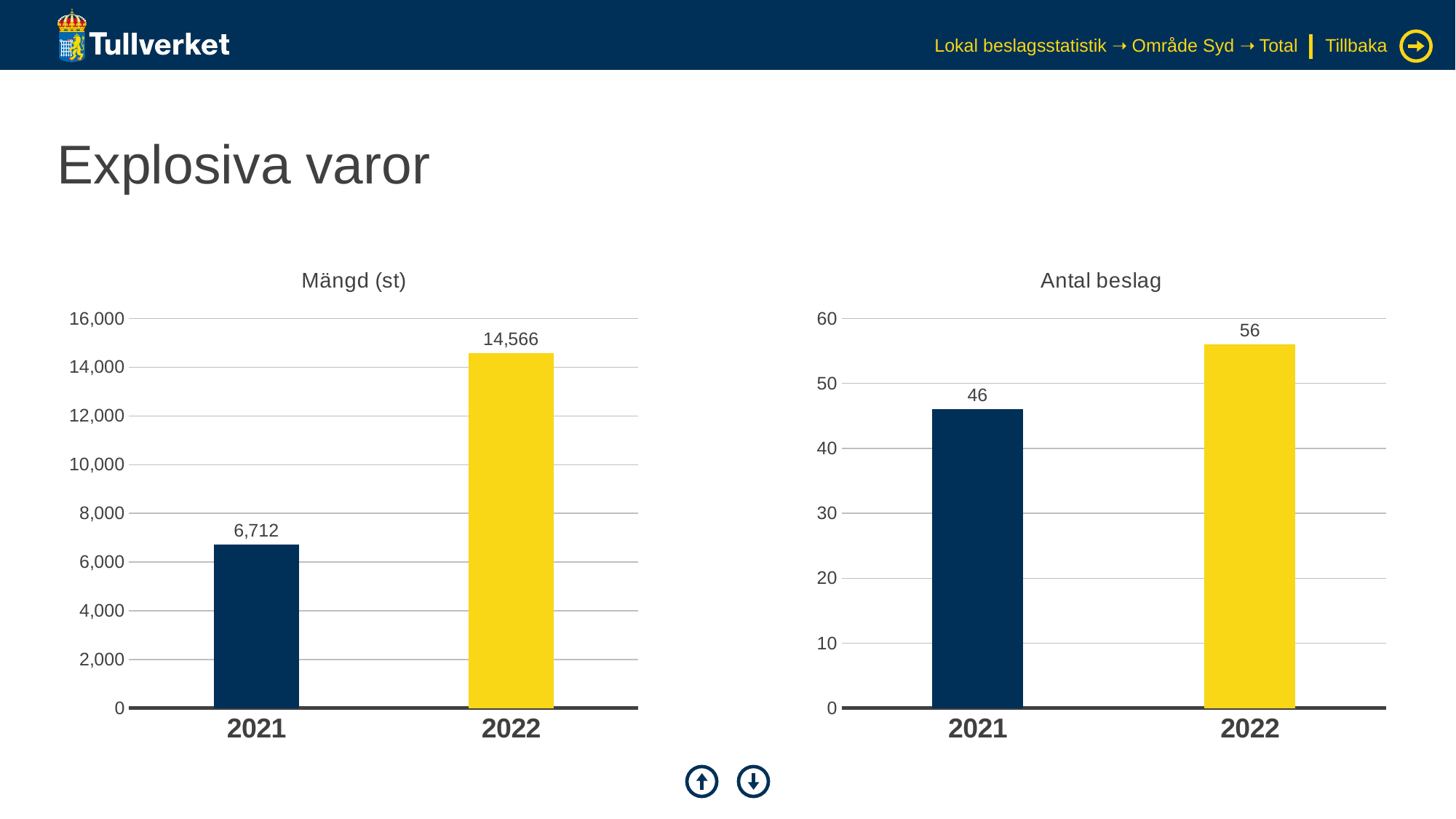
In the 'Antal beslag' chart, what is the difference between the 2022 and 2021 values? 10 In the 'Antal beslag' chart, is the value for 2021 greater or less than 50? less In the 'Mängd (st)' chart, what is the value for 2022? 14,566 In the 'Antal beslag' chart, what is the value for 2022? 56 In the 'Antal beslag' chart, which year has the lowest value? 2021 How many categories are shown on the x axis of the 'Mängd (st)' chart? 2 In the 'Mängd (st)' chart, what is the difference between the 2022 and 2021 values? 7,854 What kind of chart is the 'Antal beslag' chart? bar chart In the 'Mängd (st)' chart, what is the value for 2021? 6,712 In the 'Antal beslag' chart, what is the value for 2021? 46 In the 'Mängd (st)' chart, do the values rise or fall from 2021 to 2022? rise In the 'Mängd (st)' chart, which year has the highest value? 2022